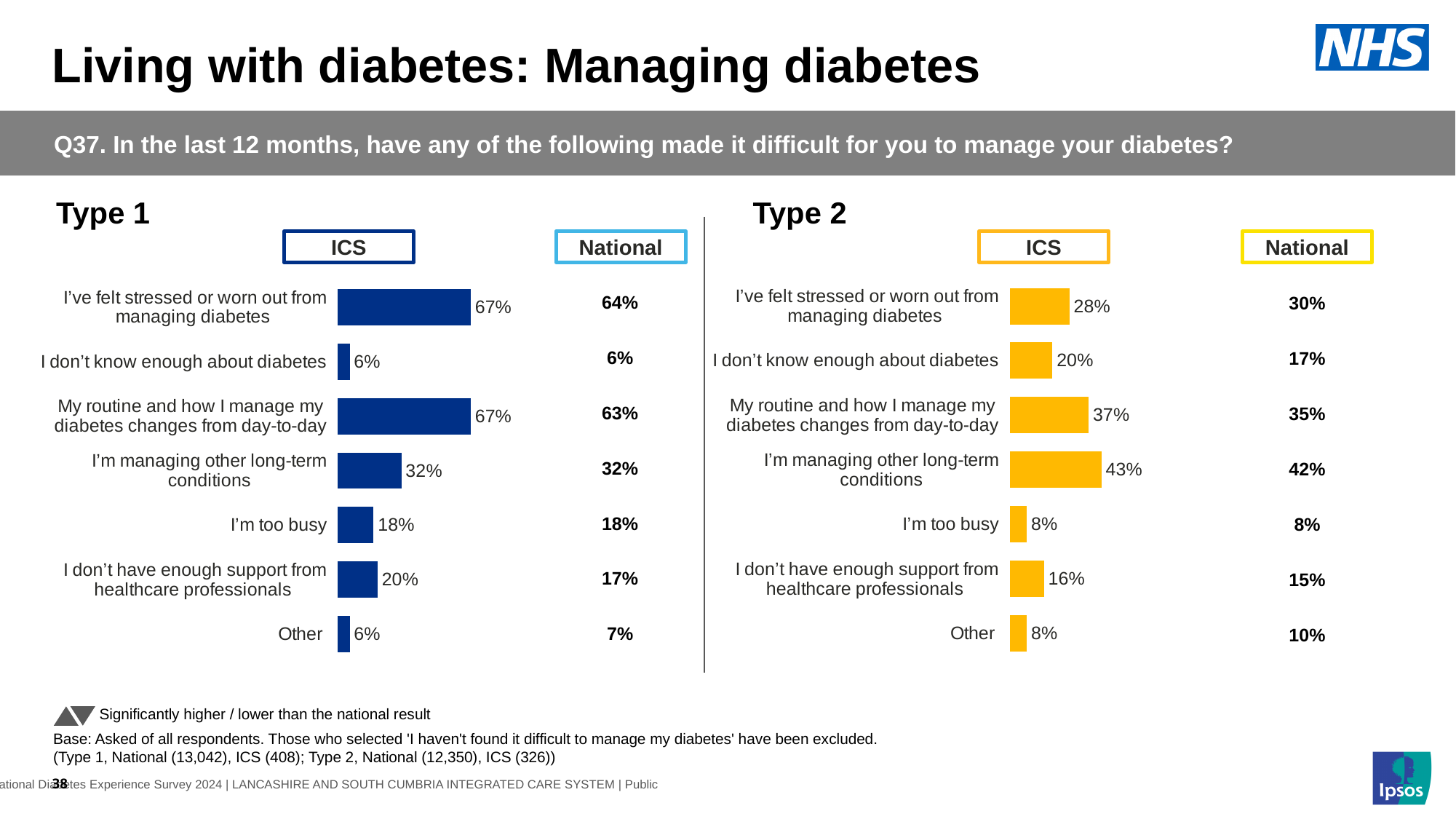
In the Type 1 chart, what is the National value for 'I don't have enough support from healthcare professionals'? 17% In the Type 2 chart, which category has the highest ICS value? I'm managing other long-term conditions How many categories are shown in the Type 1 chart? 7 What colour are the ICS bars in the Type 2 chart? Yellow In the Type 2 chart, what is the ICS value for 'My routine and how I manage my diabetes changes from day-to-day'? 37% In the Type 1 chart, what is the ICS value for 'I'm managing other long-term conditions'? 32% In the Type 2 chart, what is the National value for 'Other'? 10% In the Type 1 chart, which category has the lowest National value? I don't know enough about diabetes In the Type 2 chart, what is the difference between the ICS and National values for 'I don't know enough about diabetes'? 3 percentage points What type of chart is used for the Type 2 ICS results? Bar chart In the Type 2 chart, which is larger: the ICS value for 'I've felt stressed or worn out from managing diabetes' or the ICS value for 'I'm managing other long-term conditions'? I'm managing other long-term conditions In the Type 1 chart, what is the difference between the ICS values for 'I'm too busy' and 'Other'? 12 percentage points